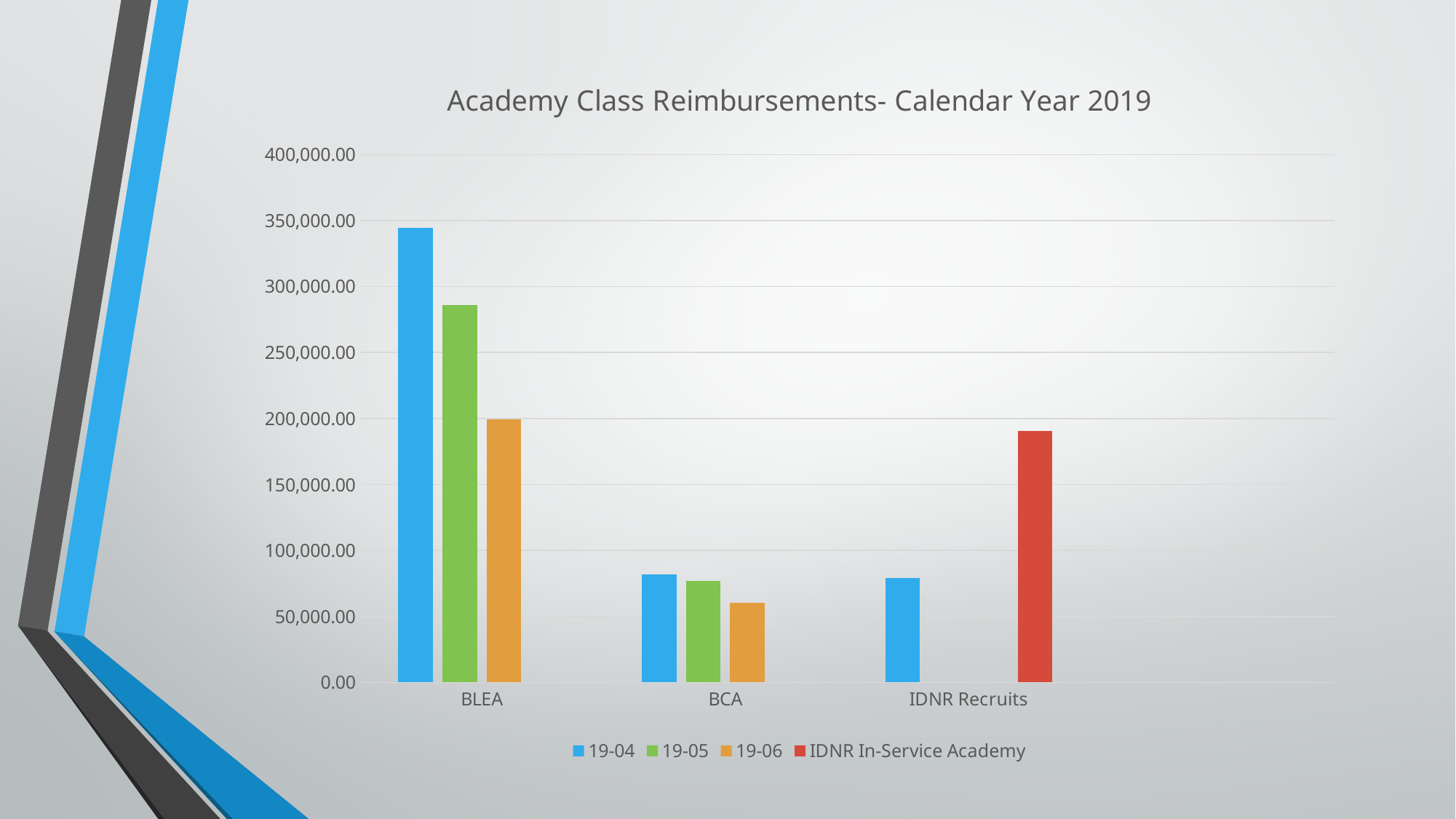
How many series does the legend list? 4 What colour represents the IDNR In-Service Academy series? Red Within the BLEA category, which series has the highest value? 19-04 Which is larger: the 19-05 value for BLEA or the IDNR In-Service Academy value for IDNR Recruits? 19-05 value for BLEA Which category has the tallest bar in the chart? BLEA Within the BCA category, which series has the lowest value? 19-06 Is the value for IDNR In-Service Academy in IDNR Recruits greater or less than 200,000.00? less How many categories are shown on the x axis? 3 What kind of chart is shown on the slide? Bar chart Is the value for 19-06 in BCA greater or less than 100,000.00? less Is the value for 19-04 in BLEA greater or less than 300,000.00? greater What is the title of the chart? Academy Class Reimbursements- Calendar Year 2019